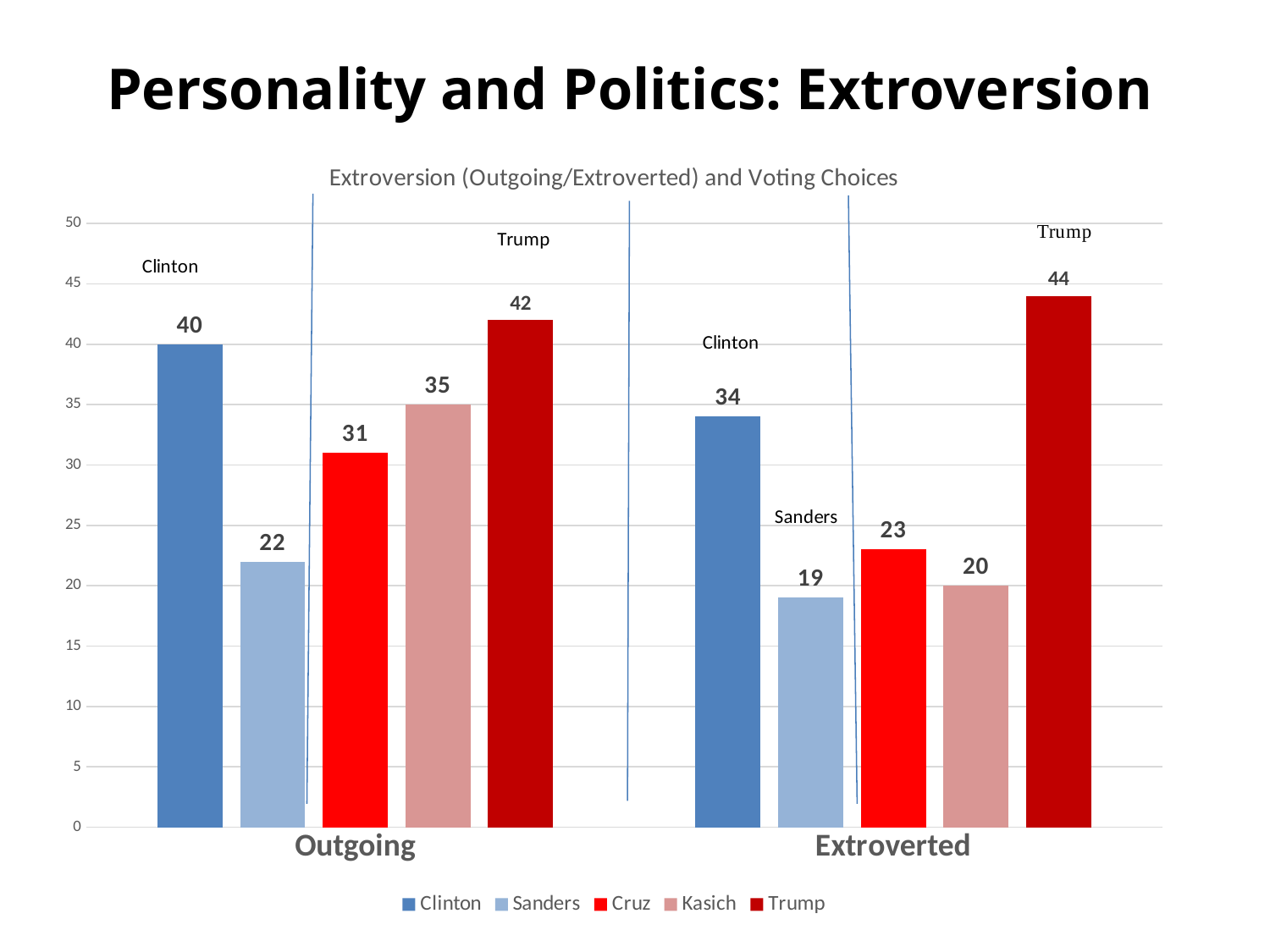
What is the value for Trump in the Extroverted category? 44 Which is larger in the Outgoing category: Cruz or Kasich? Kasich Which series has the lowest value in the Extroverted category? Sanders Which series has the highest value in the Outgoing category? Trump What is the value for Sanders in the Extroverted category? 19 What is the value for Kasich in the Outgoing category? 35 What is the title of the chart? Extroversion (Outgoing/Extroverted) and Voting Choices How many categories are shown on the x axis? 2 What kind of chart is shown on the slide? Bar chart How many series does the legend list? 5 What is the value for Clinton in the Outgoing category? 40 What is the difference between Trump's and Clinton's values in the Extroverted category? 10